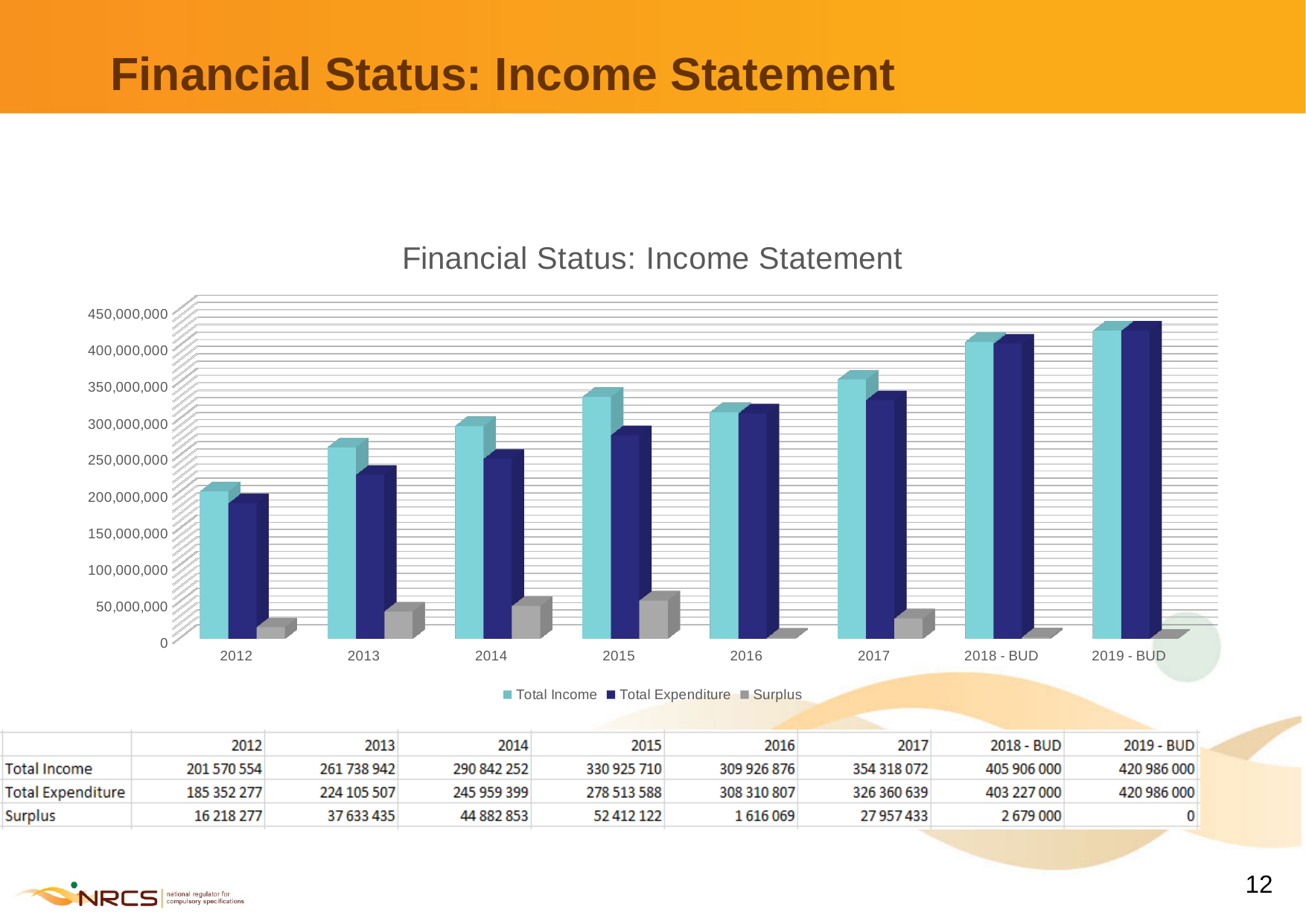
What kind of chart is shown on the slide? bar chart What is the difference between Total Income in 2015 and Total Income in 2014? 40 083 458 Does Total Expenditure rise or fall from 2012 to 2019 - BUD? rise How many years are shown on the x axis of the chart? 8 What is the Total Income for 2015? 330 925 710 Which year has the lowest Surplus? 2019 - BUD Is the Total Expenditure for 2013 greater or less than 250,000,000? less How many series does the chart legend list? 3 Which year has the highest Surplus? 2015 What is the Total Expenditure for 2018 - BUD? 403 227 000 What is the Surplus for 2016? 1 616 069 Which is larger, Total Income in 2015 or Total Income in 2016? Total Income in 2015